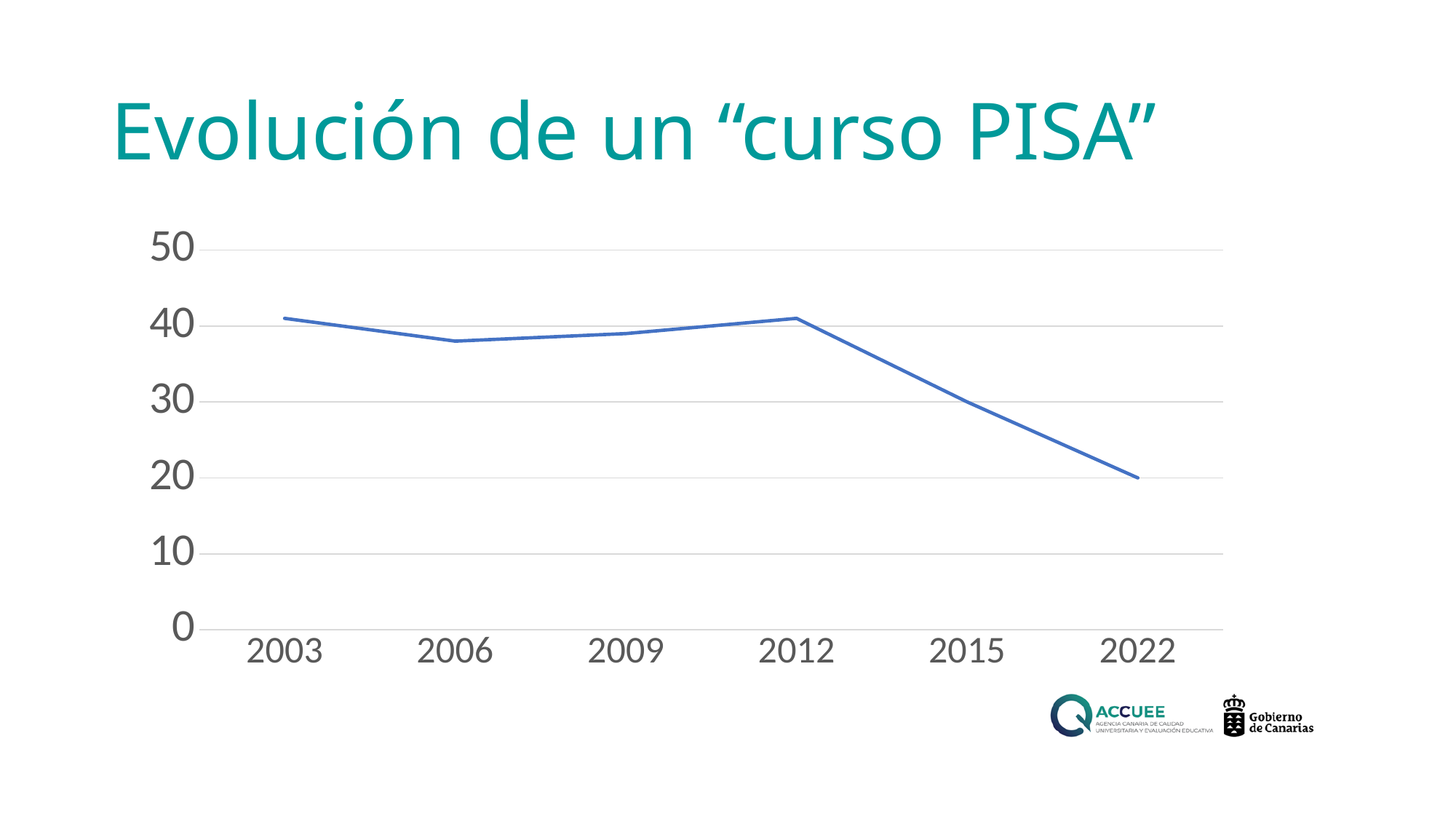
Is the value for 2006 greater or less than 40? less Does the line rise or fall between 2012 and 2022? fall How many years are plotted along the x axis? 6 Is the value for 2015 greater or less than 20? greater What is the value for 2022? 20 Which is larger, the value for 2006 or the value for 2022? 2006 What kind of chart is shown on the slide? line chart What is the title of the chart on the slide? Evolución de un "curso PISA" Is the value for 2009 greater or less than 30? greater Which is larger, the value for 2012 or the value for 2015? 2012 Which year has the lowest value? 2022